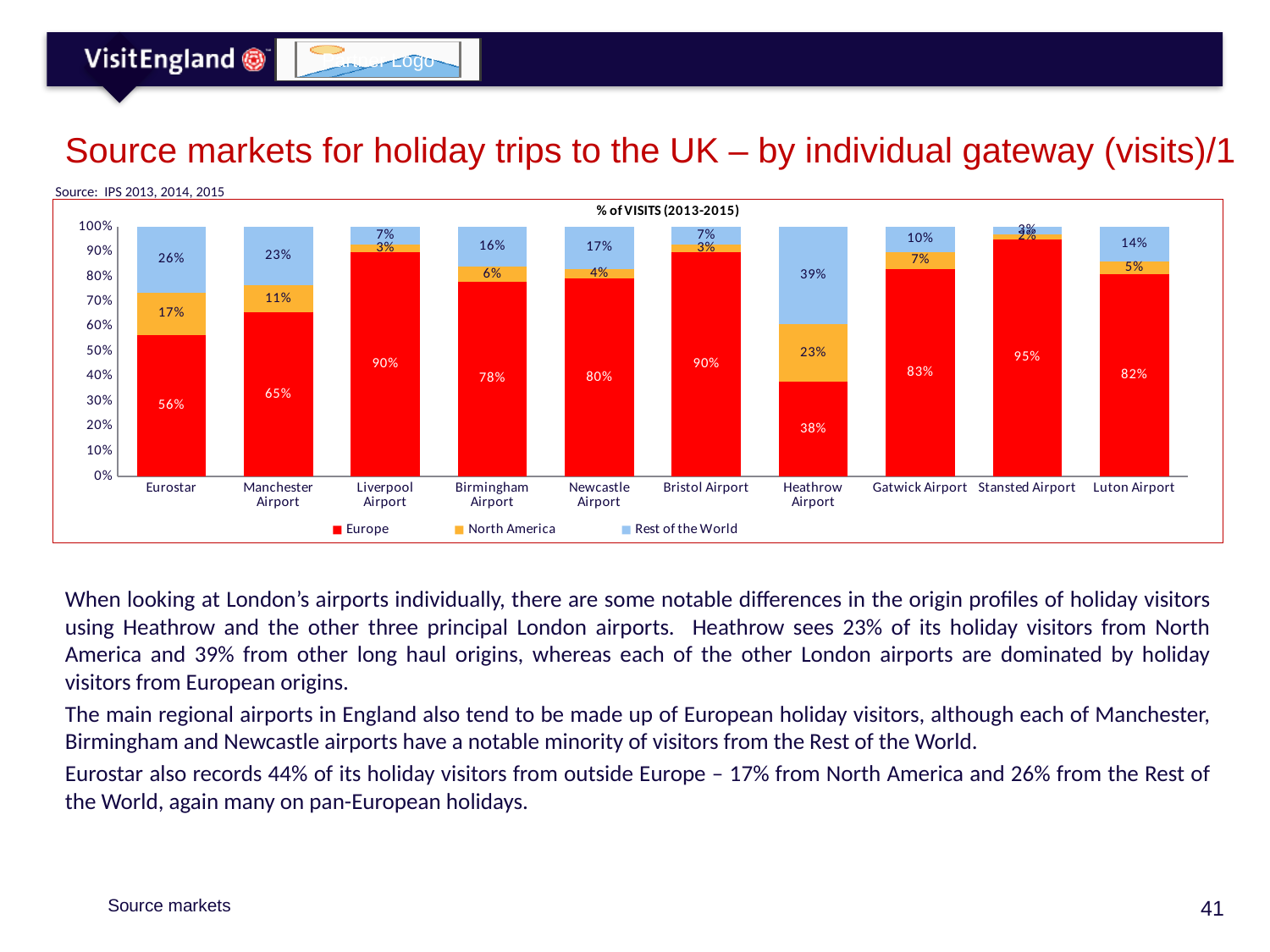
What kind of chart is shown on the slide? Stacked bar chart What is the difference between the Europe share for Newcastle Airport and Birmingham Airport? 2% How many gateways (categories) are shown on the x axis? 10 What is the Europe share of holiday visits for Heathrow Airport? 38% How many series does the legend list? 3 Which gateway has the lowest Europe share? Heathrow Airport What is the title shown above the chart? % of VISITS (2013-2015) What is the Rest of the World share of holiday visits for Manchester Airport? 23% Which gateway has the highest Europe share? Stansted Airport What is the North America share of holiday visits for Eurostar? 17% Which is larger: the Rest of the World share for Heathrow Airport or for Eurostar? Heathrow Airport Is the Europe share for Gatwick Airport greater or less than 50%? greater